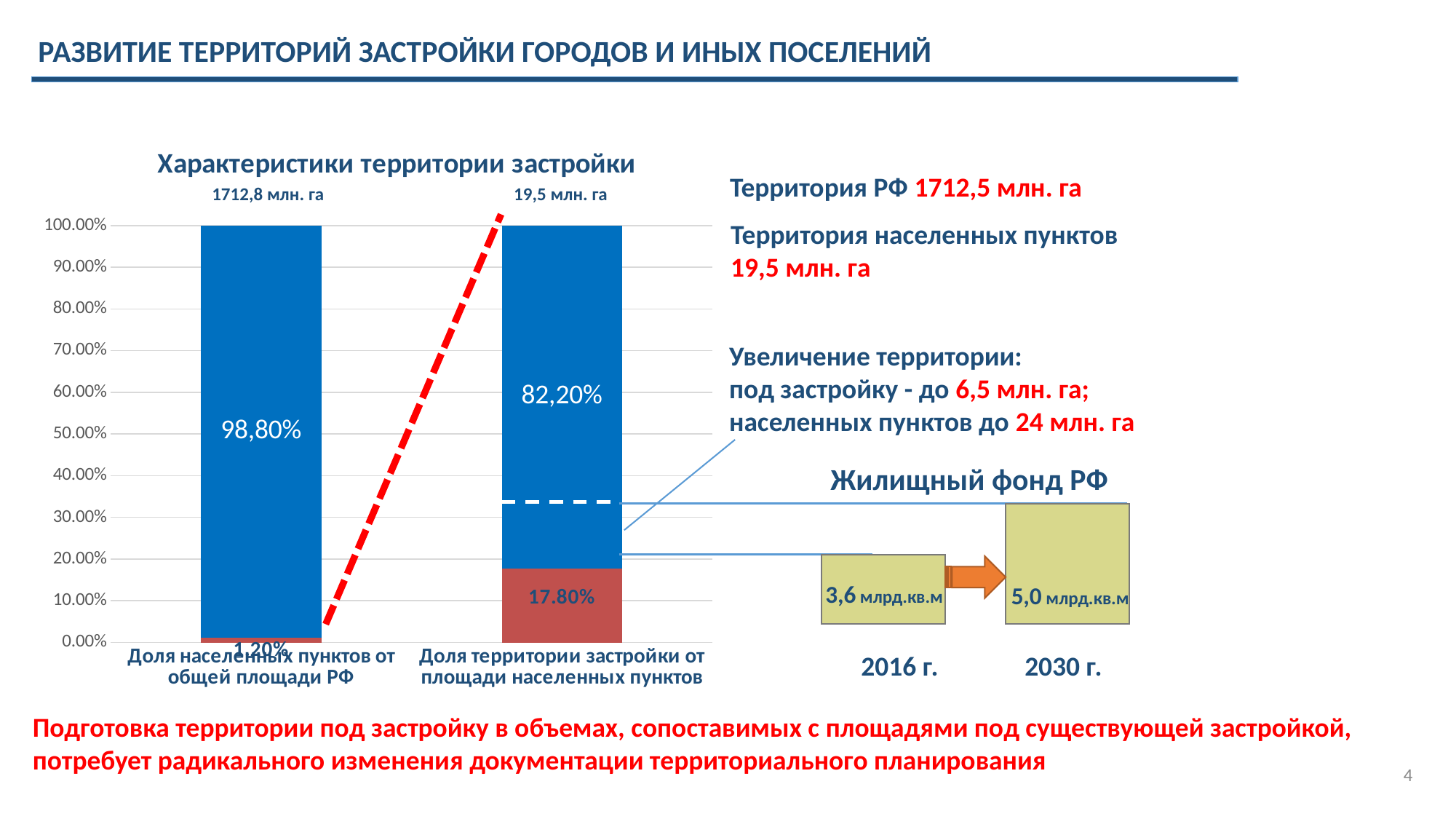
In the "Характеристики территории застройки" chart, what area value is printed above the bar "Доля населенных пунктов от общей площади РФ"? 1712,8 млн. га In the "Характеристики территории застройки" chart, what value is labelled on the red segment of the bar "Доля территории застройки от площади населенных пунктов"? 17.80% In the "Жилищный фонд РФ" graphic, does the value rise or fall from 2016 г. to 2030 г.? rise In the "Характеристики территории застройки" chart, which bar has the larger red segment? Доля территории застройки от площади населенных пунктов How many categories are shown on the x axis of the "Характеристики территории застройки" chart? 2 In the "Характеристики территории застройки" chart, what value is labelled on the red segment of the bar "Доля населенных пунктов от общей площади РФ"? 1,20% What kind of chart is "Характеристики территории застройки"? bar chart In the "Характеристики территории застройки" chart, what value is labelled on the blue segment of the bar "Доля территории застройки от площади населенных пунктов"? 82,20% In the "Характеристики территории застройки" chart, is the red segment of the bar "Доля территории застройки от площади населенных пунктов" greater or less than 20.00%? less In the "Характеристики территории застройки" chart, what is the difference between the blue segment values of the two bars (98,80% and 82,20%)? 16,60% In the "Жилищный фонд РФ" graphic, what value is shown for 2016 г.? 3,6 млрд.кв.м In the "Характеристики территории застройки" chart, what value is labelled on the blue segment of the bar "Доля населенных пунктов от общей площади РФ"? 98,80%